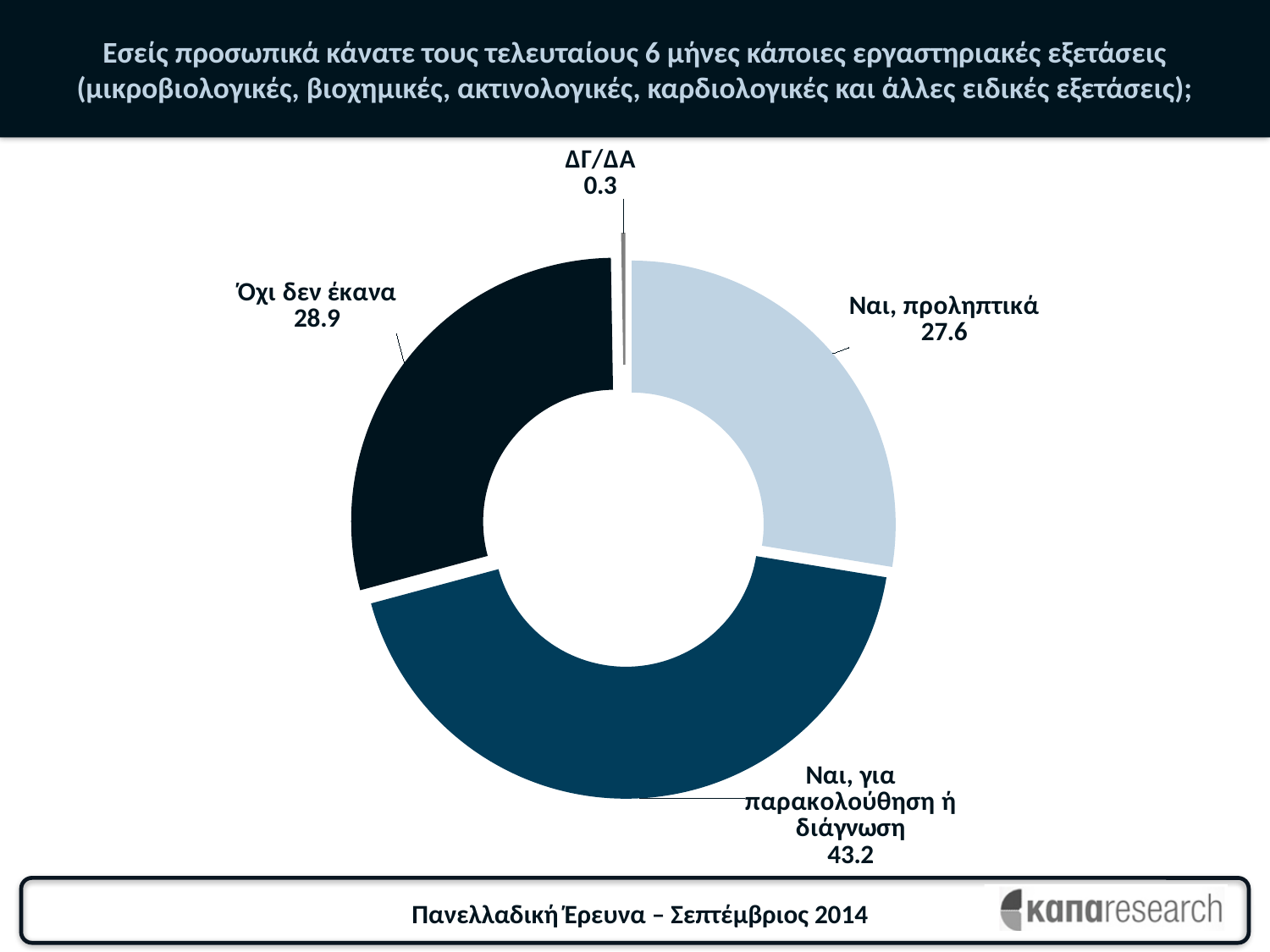
Which category has the smallest slice? ΔΓ/ΔΑ What value is shown for the 'Όχι δεν έκανα' slice? 28.9 What survey and date are given in the footer of the slide? Πανελλαδική Έρευνα – Σεπτέμβριος 2014 Which category has the largest slice? Ναι, για παρακολούθηση ή διάγνωση How many categories are shown in the chart? 4 What is the difference between the values for 'Όχι δεν έκανα' and 'Ναι, προληπτικά'? 1.3 What is the difference between the values for 'Ναι, για παρακολούθηση ή διάγνωση' and 'Όχι δεν έκανα'? 14.3 What value is shown for the 'Ναι, προληπτικά' slice? 27.6 What value is shown for the 'Ναι, για παρακολούθηση ή διάγνωση' slice? 43.2 What value is shown for the 'ΔΓ/ΔΑ' slice? 0.3 What kind of chart is shown on the slide? Pie chart (doughnut) Which is larger, the value for 'Ναι, για παρακολούθηση ή διάγνωση' or the value for 'Ναι, προληπτικά'? Ναι, για παρακολούθηση ή διάγνωση